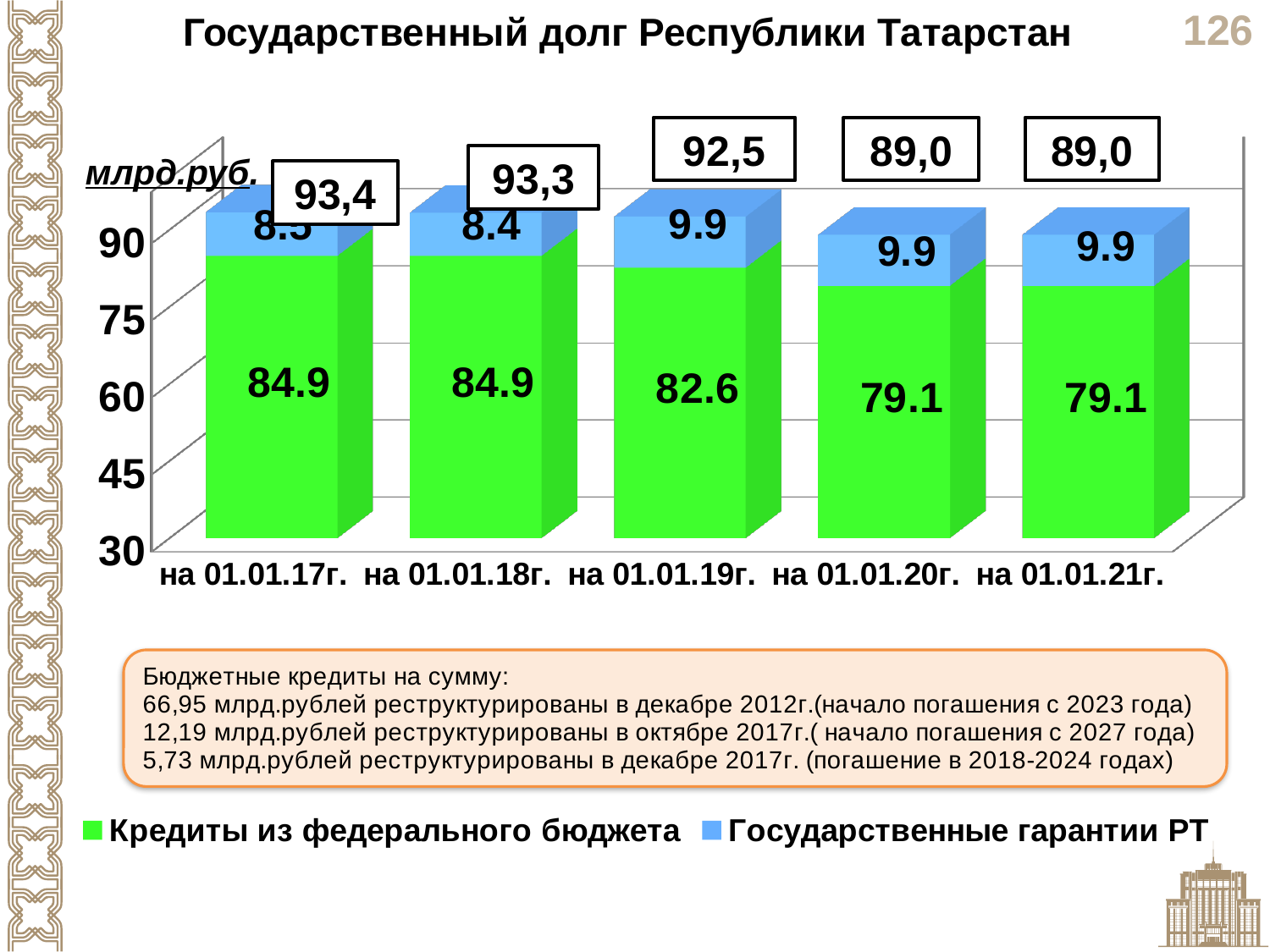
How many dates (categories) are shown on the x axis? 5 Which date has the highest total state debt? на 01.01.17г. (93,4) What is the value of Кредиты из федерального бюджета on 01.01.19г.? 82.6 What is the value of Государственные гарантии РТ on 01.01.18г.? 8.4 What is the total state debt shown above the bar for 01.01.21г.? 89,0 What is the difference between Кредиты из федерального бюджета on 01.01.18г. and on 01.01.19г.? 2.3 Is the value for Кредиты из федерального бюджета on 01.01.20г. greater or less than 75? greater Which date has the lowest value for Кредиты из федерального бюджета? на 01.01.20г. and на 01.01.21г. (79.1) What is the value of Государственные гарантии РТ on 01.01.20г.? 9.9 How many series does the legend list? 2 What is the total state debt shown above the bar for 01.01.17г.? 93,4 What kind of chart is shown on the slide? Stacked bar chart